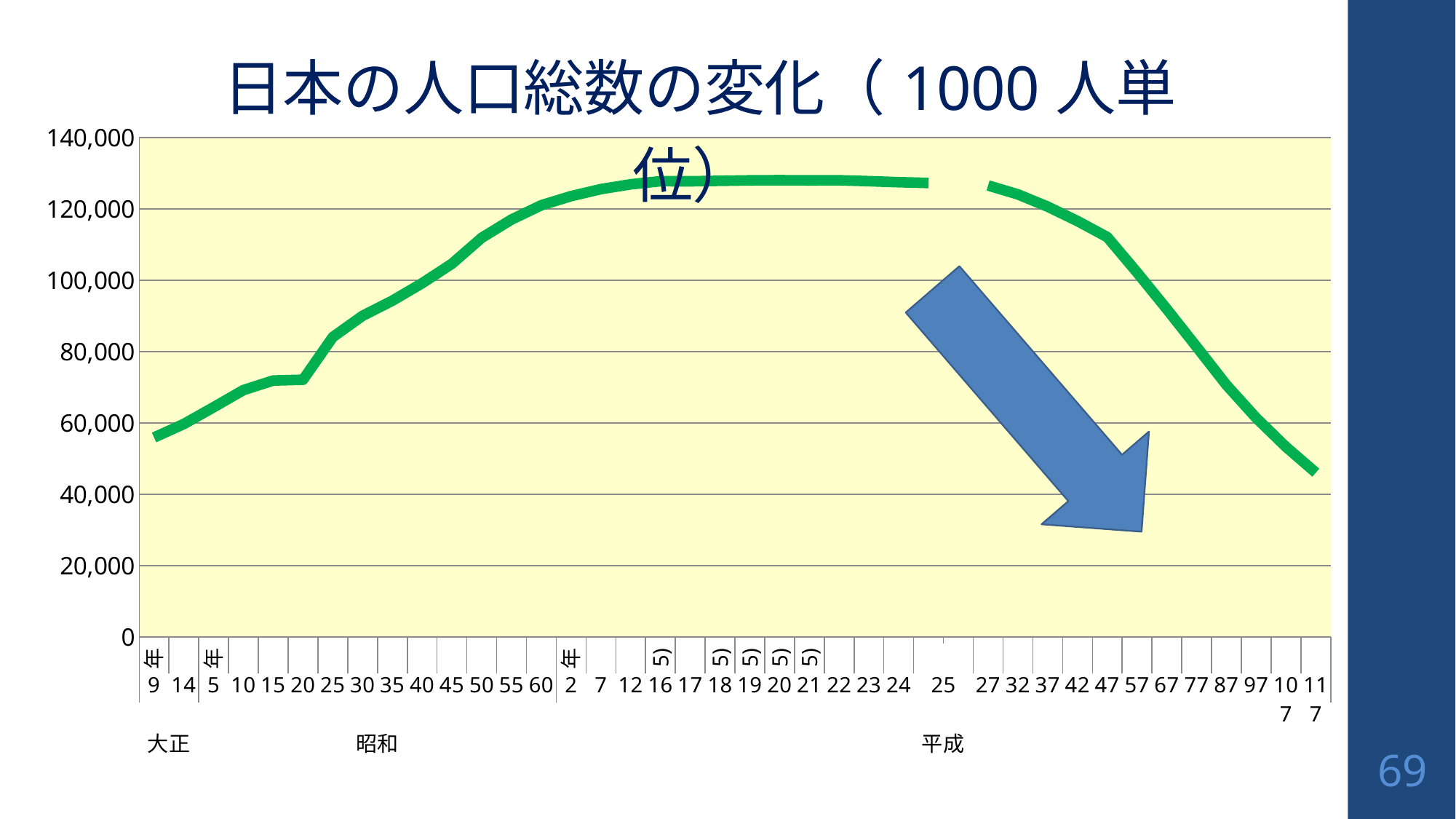
Is the value for 平成117 greater or less than 40,000? greater Is the value for 平成47 greater or less than 100,000? greater What is the title of the chart? 日本の人口総数の変化（1000人単位） Is the value for 平成77 greater or less than 100,000? less Do the values rise or fall along the x axis from 平成27 to 平成117? fall Which category has the lowest value on the chart? 平成117 Which is larger, the value for 大正9 or the value for 平成117? 大正9 What kind of chart is shown on the slide? line chart Which three era labels appear beneath the x axis of the chart? 大正, 昭和, 平成